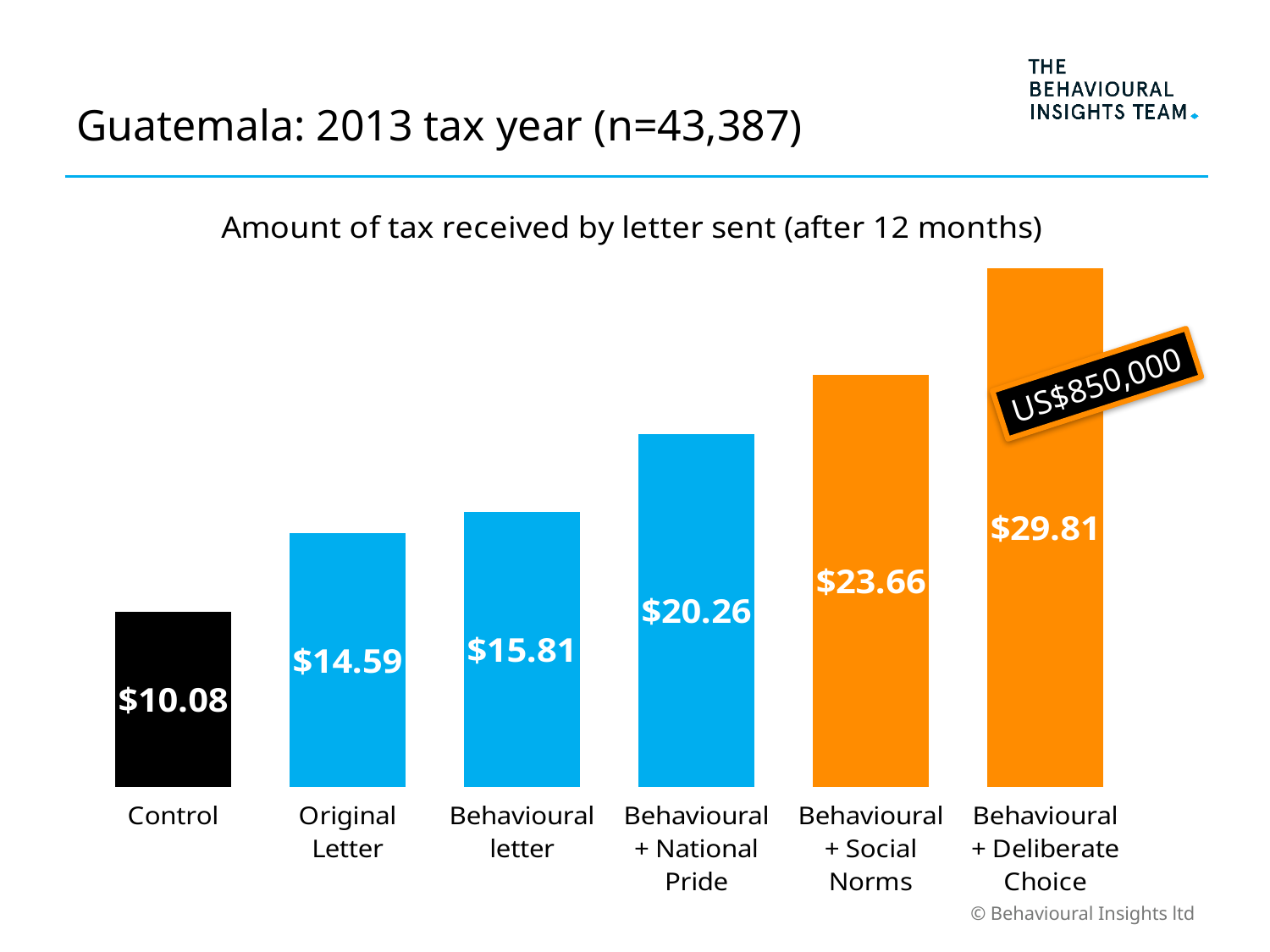
Which letter type has the highest amount of tax received per letter? Behavioural + Deliberate Choice Which is larger, the value for the Original Letter or the Behavioural letter? Behavioural letter What is the difference between the Behavioural + Deliberate Choice value and the Control value? $19.73 What is the title of the chart? Amount of tax received by letter sent (after 12 months) What kind of chart is shown on the slide? Bar chart How many categories are shown in the chart? 6 What is the value for the Behavioural + Social Norms letter? $23.66 What is the amount of tax received per letter for the Control group? $10.08 Which category has the lowest value? Control Do the values rise or fall from left to right across the categories? Rise What is the difference between the Behavioural letter and the Original Letter values? $1.22 What is the value for the Behavioural + National Pride letter? $20.26